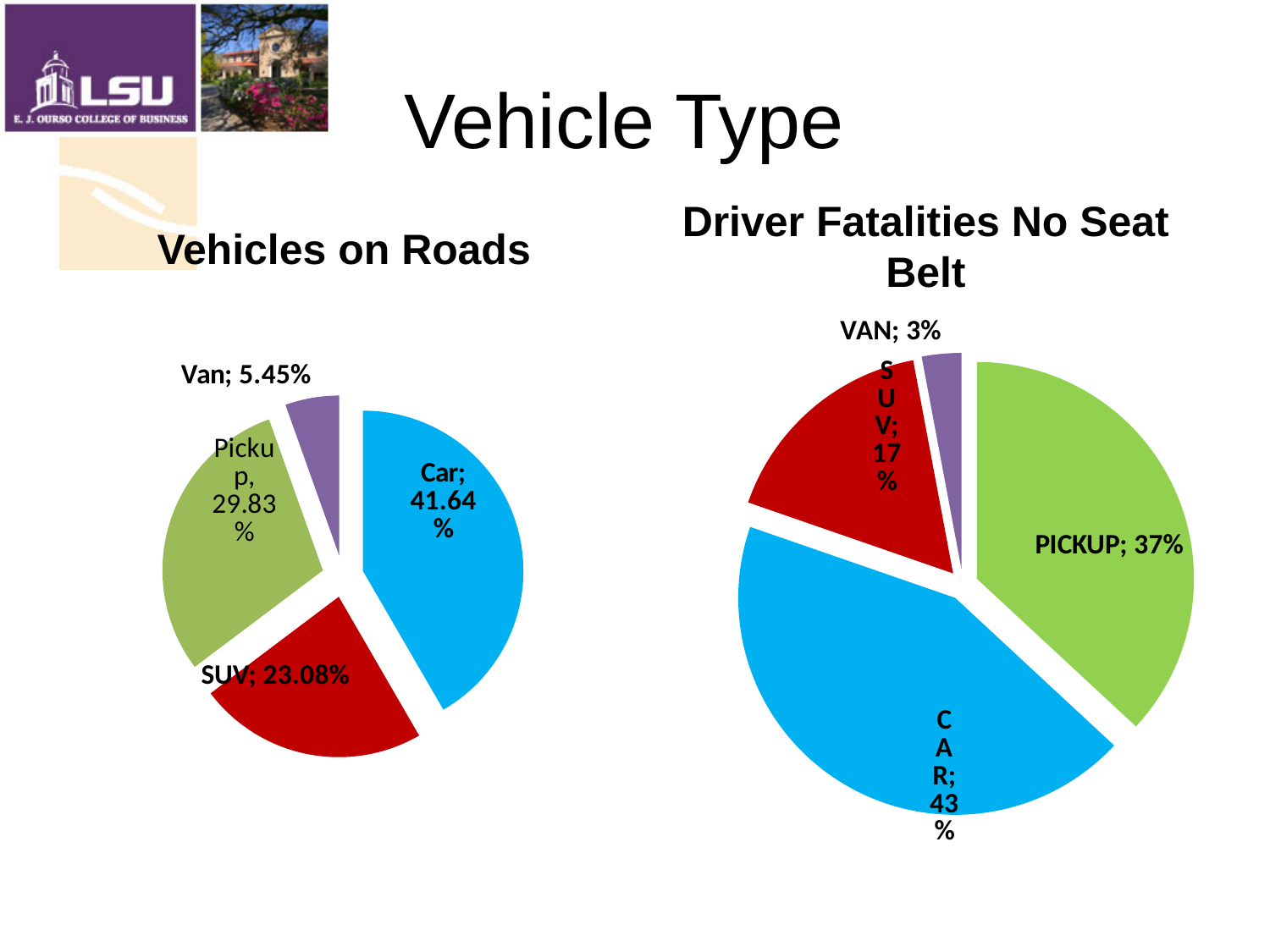
In the 'Vehicles on Roads' chart, which vehicle type has the smallest slice? Van In the 'Vehicles on Roads' chart, which is larger, the Pickup slice or the SUV slice? Pickup In the 'Vehicles on Roads' chart, what share of vehicles are cars? 41.64% How many slices does the 'Driver Fatalities No Seat Belt' chart have? 4 In the 'Vehicles on Roads' chart, which vehicle type has the largest slice? Car In the 'Driver Fatalities No Seat Belt' chart, what is the value for PICKUP? 37% In the 'Driver Fatalities No Seat Belt' chart, what is the difference between the CAR and SUV shares? 26% In the 'Driver Fatalities No Seat Belt' chart, what is the value for VAN? 3% What type of chart is the 'Vehicles on Roads' chart? Pie chart In the 'Vehicles on Roads' chart, what is the value for Pickup? 29.83% In the 'Driver Fatalities No Seat Belt' chart, which vehicle type has the largest share? CAR In the 'Vehicles on Roads' chart, what is the value for SUV? 23.08%